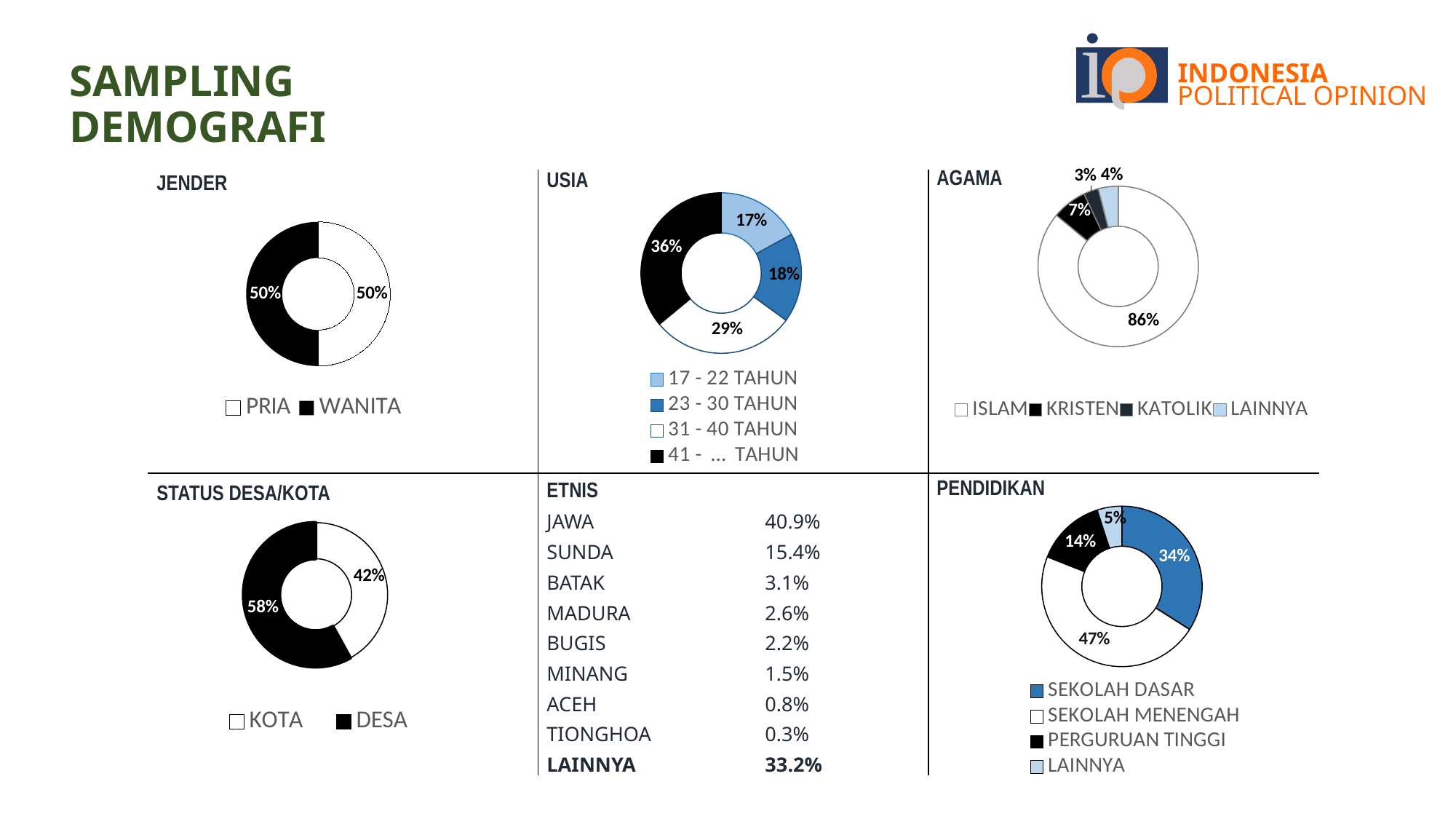
How many categories does the legend of the AGAMA chart list? 4 In the AGAMA chart, what share is KRISTEN? 7% In the PENDIDIKAN chart, what share is PERGURUAN TINGGI? 14% In the USIA chart, which age group has the smallest share? 17 - 22 TAHUN In the USIA chart, what is the difference between the 41 - ... TAHUN share and the 23 - 30 TAHUN share? 18% What type of chart is used for PENDIDIKAN? Donut chart In the AGAMA chart, what share is ISLAM? 86% In the JENDER chart, what share is WANITA? 50% In the STATUS DESA/KOTA chart, what is the difference between DESA and KOTA? 16% In the USIA chart, which age group has the largest share? 41 - ... TAHUN In the USIA chart, what share is the 31 - 40 TAHUN group? 29% In the STATUS DESA/KOTA chart, which is larger, KOTA or DESA? DESA